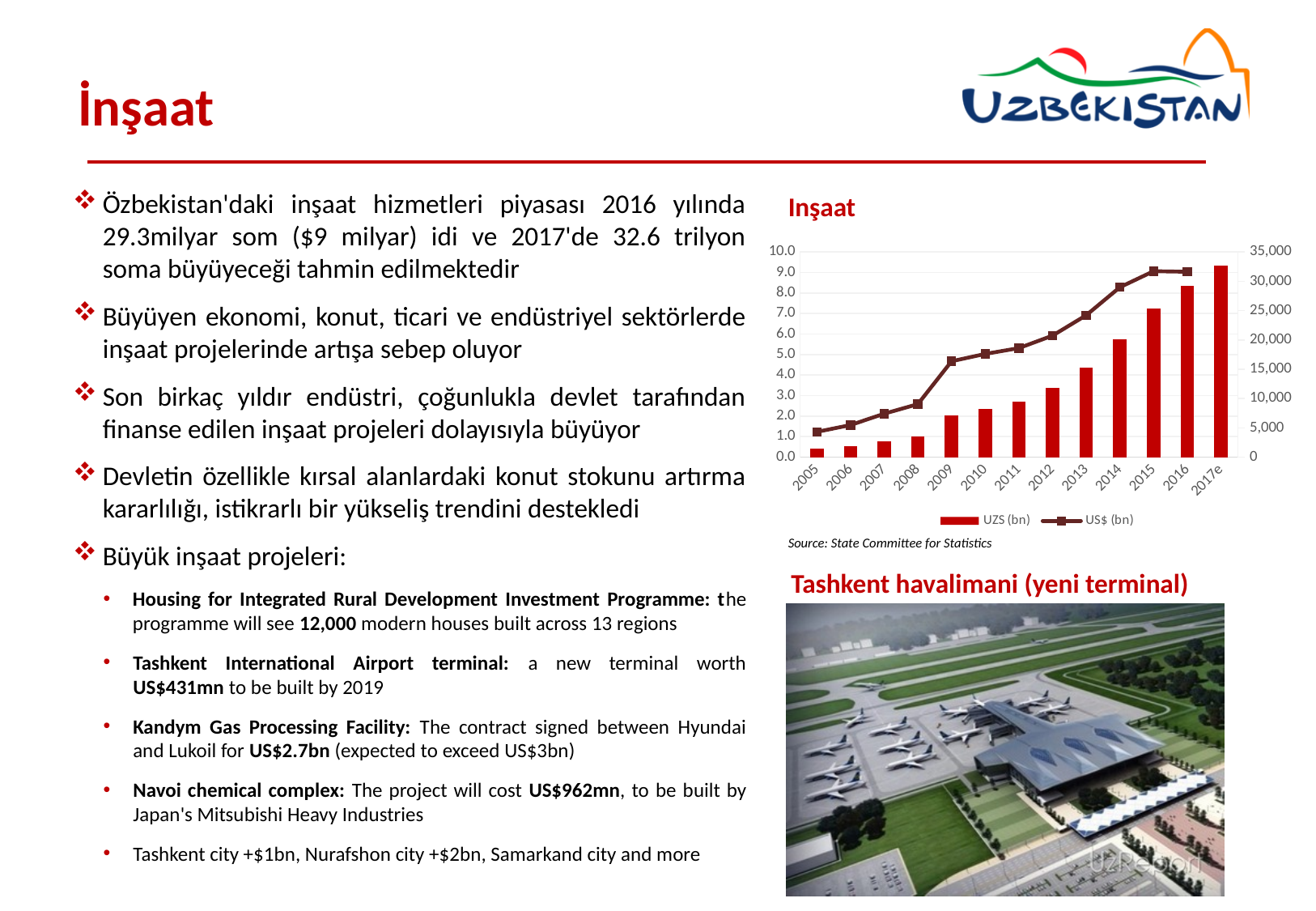
Is the UZS (bn) value for 2017e in the İnşaat chart greater or less than 30,000? greater Is the US$ (bn) value for 2009 in the İnşaat chart greater or less than 4.0? greater What kind of chart is shown under the title "İnşaat"? A combined bar and line chart Which year has the tallest UZS (bn) bar in the İnşaat chart? 2017e In the İnşaat chart, is the US$ (bn) value larger in 2013 or in 2010? 2013 What are the two series named in the legend of the İnşaat chart? UZS (bn) and US$ (bn) How many years are shown on the x axis of the İnşaat chart? 13 Do the UZS (bn) bars in the İnşaat chart generally rise or fall from 2005 to 2017e? Rise Is the UZS (bn) value for 2005 in the İnşaat chart greater or less than 5,000? less What source is cited below the İnşaat chart? State Committee for Statistics How many series does the legend of the İnşaat chart list? 2 Which year has the shortest UZS (bn) bar in the İnşaat chart? 2005